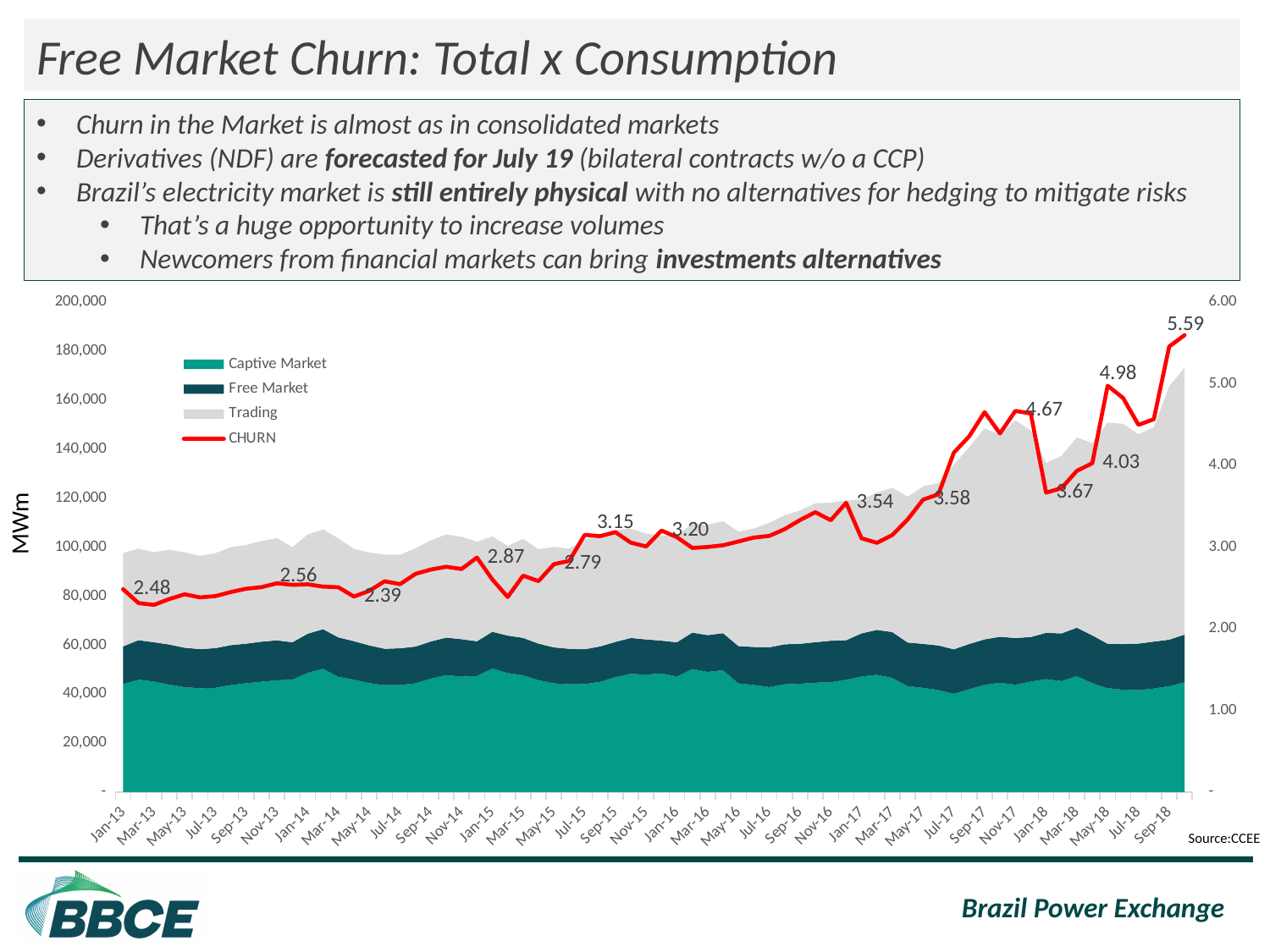
Is the Captive Market value at Jan-13 greater or less than 60,000? less What is the highest CHURN value labelled on the chart? 5.59 What is the CHURN value labelled at the first point of the line (Jan-13)? 2.48 How many series does the chart legend list? 4 What is the difference between the highest labelled CHURN value (5.59) and the lowest labelled CHURN value (2.39)? 3.20 Is the total stacked value (Captive Market + Free Market + Trading) at Sep-18 greater or less than 140,000? greater What is the difference between the labelled CHURN values 4.98 and 4.67? 0.31 What is the CHURN value labelled at the last point of the line (Sep-18)? 5.59 What is the lowest CHURN value labelled on the chart? 2.39 What unit is shown on the left vertical axis label? MWm Which labelled CHURN value is larger, 3.54 or 3.58? 3.58 Does the CHURN line generally rise or fall from Jan-13 to Sep-18? rise